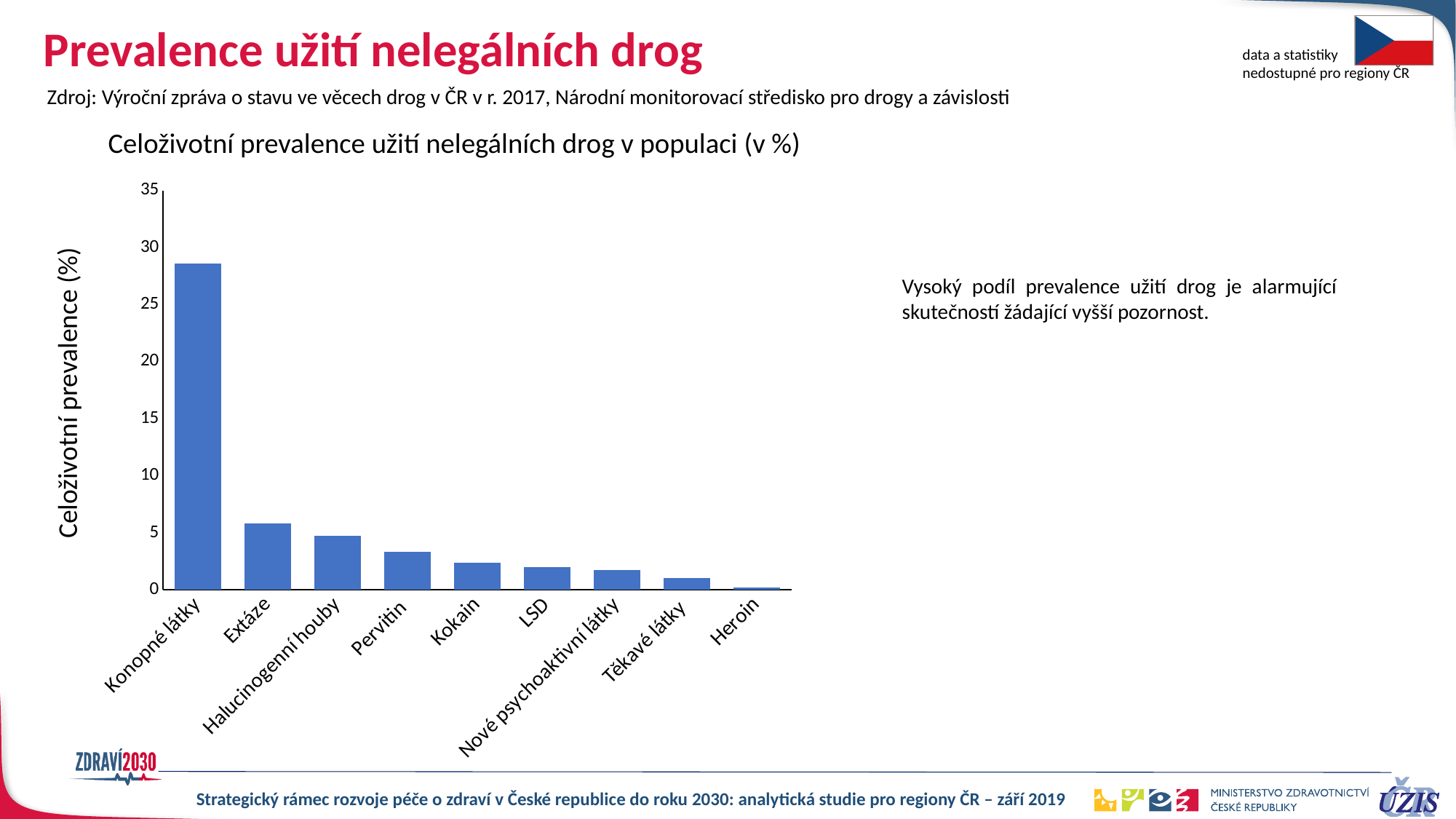
Do the values rise or fall moving from left to right along the x axis? Fall Which category has the lowest lifetime prevalence in the chart? Heroin Which is larger, the value for Extáze or the value for Pervitin? Extáze Which is larger, the value for Kokain or the value for Těkavé látky? Kokain Which category has the highest lifetime prevalence in the chart? Konopné látky What kind of chart is shown on the slide? Bar chart Is the value for Extáze greater or less than 10? less Is the value for Konopné látky greater or less than 25? greater How many categories are shown on the x axis of the chart? 9 What is the title of the chart? Celoživotní prevalence užití nelegálních drog v populaci (v %) What is the label of the y axis? Celoživotní prevalence (%)